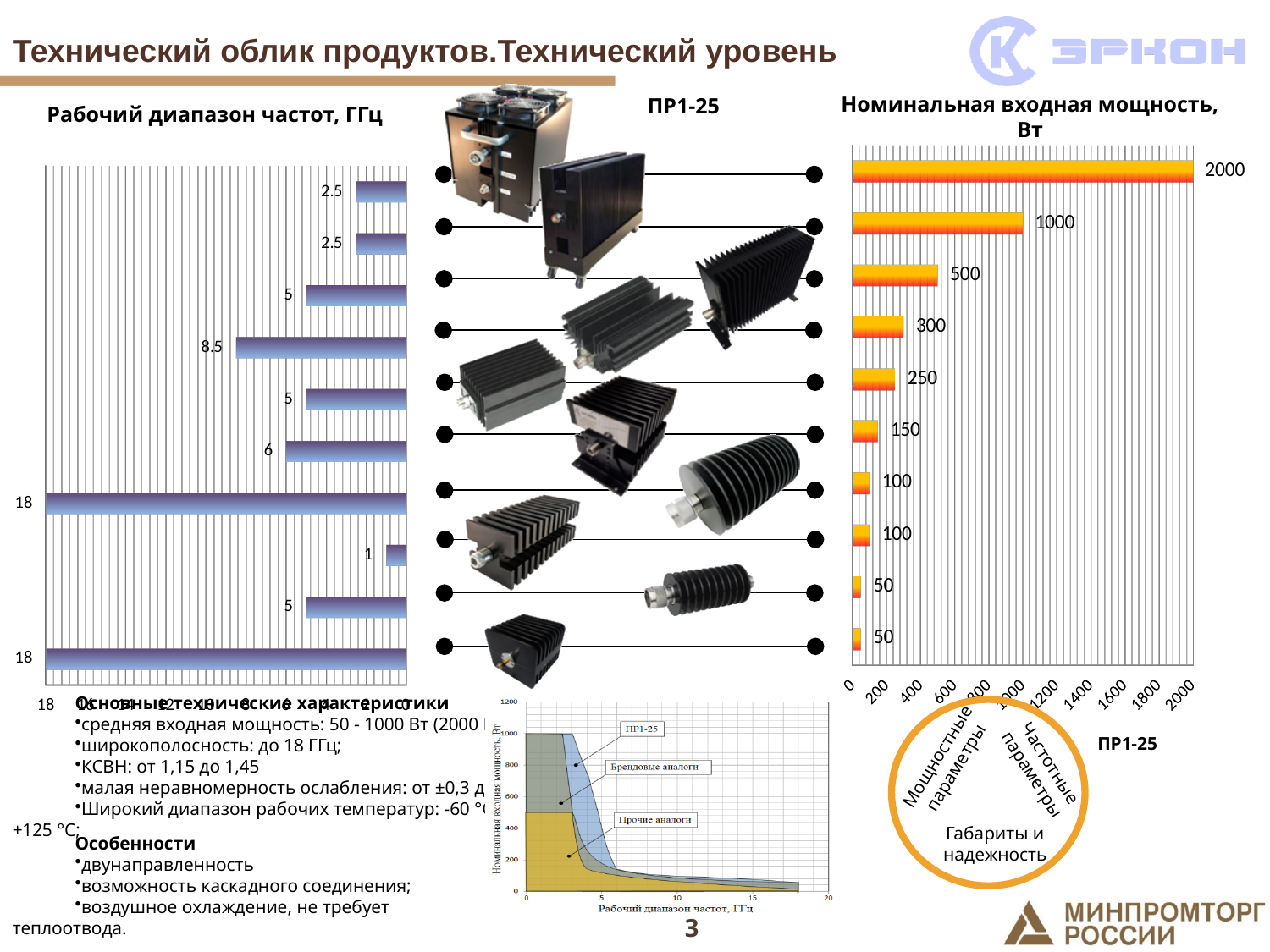
How many bars are in the chart titled 'Номинальная входная мощность, Вт'? 10 In the chart titled 'Рабочий диапазон частот, ГГц', which is larger: the fourth bar from the top or the sixth bar from the top? the fourth bar from the top In the chart titled 'Рабочий диапазон частот, ГГц', what is the value of the fourth bar from the top? 8.5 In the chart titled 'Рабочий диапазон частот, ГГц', what is the highest value shown? 18 In the chart titled 'Номинальная входная мощность, Вт', what is the value of the topmost bar? 2000 In the chart titled 'Номинальная входная мощность, Вт', what is the value of the third bar from the top? 500 In the chart titled 'Номинальная входная мощность, Вт', what is the difference between the top bar and the second bar from the top? 1000 In the chart titled 'Номинальная входная мощность, Вт', what is the lowest value shown? 50 In the chart titled 'Рабочий диапазон частот, ГГц', what is the lowest value shown? 1 In the chart titled 'Номинальная входная мощность, Вт', what is the highest value shown? 2000 What kind of chart is the one titled 'Рабочий диапазон частот, ГГц'? bar chart